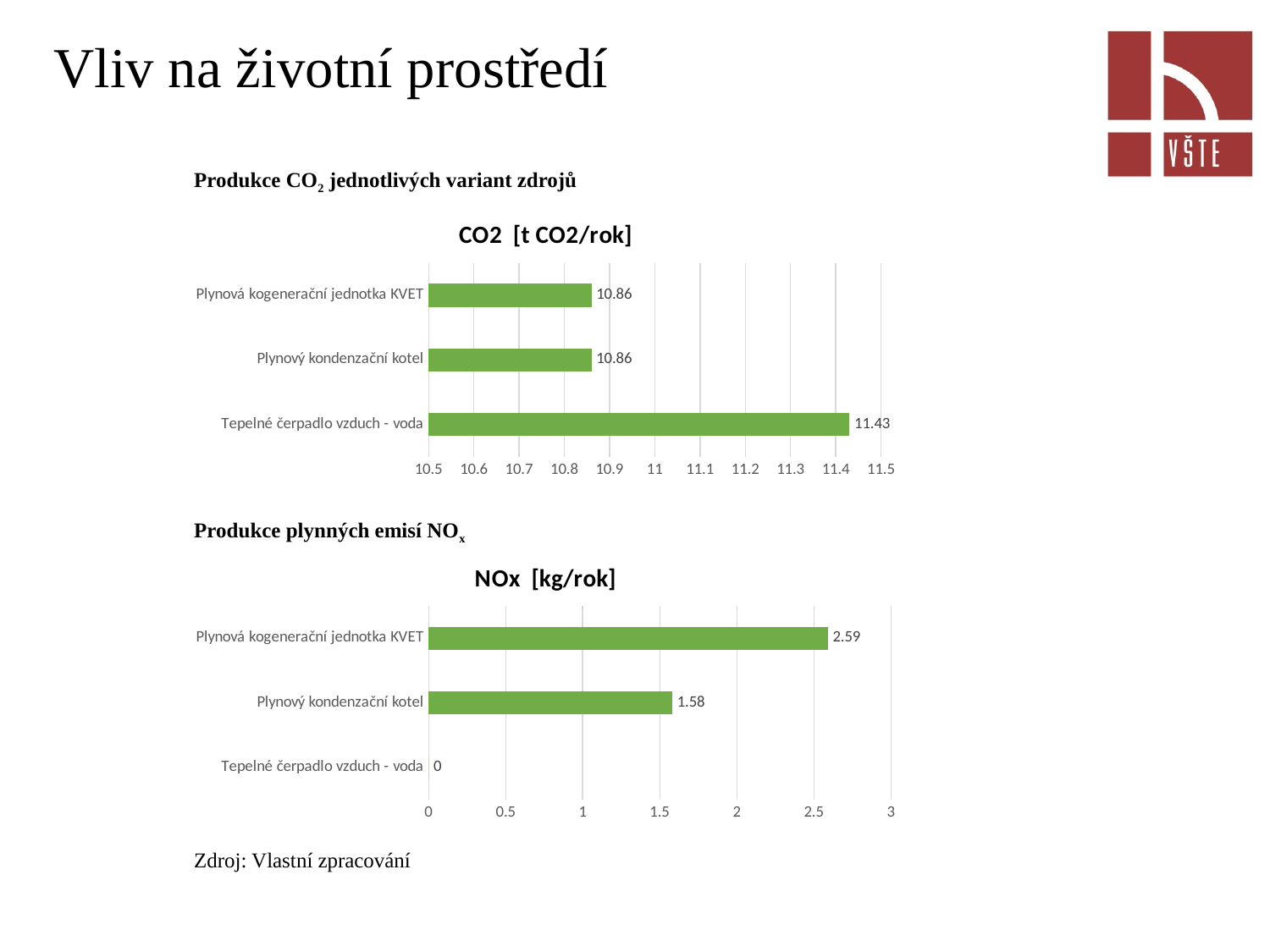
In the CO2 [t CO2/rok] chart, how many categories are shown? 3 In the NOx [kg/rok] chart, what is the value for Plynová kogenerační jednotka KVET? 2.59 In the CO2 [t CO2/rok] chart, which category has the highest value? Tepelné čerpadlo vzduch - voda In the NOx [kg/rok] chart, which is larger: Plynová kogenerační jednotka KVET or Plynový kondenzační kotel? Plynová kogenerační jednotka KVET In the CO2 [t CO2/rok] chart, what is the value for Tepelné čerpadlo vzduch - voda? 11.43 In the NOx [kg/rok] chart, what is the value for Tepelné čerpadlo vzduch - voda? 0 In the NOx [kg/rok] chart, is the value for Plynový kondenzační kotel greater or less than 2? less In the NOx [kg/rok] chart, what is the difference between Plynová kogenerační jednotka KVET and Plynový kondenzační kotel? 1.01 What kind of chart is the NOx [kg/rok] chart? bar chart In the NOx [kg/rok] chart, which category has the lowest value? Tepelné čerpadlo vzduch - voda In the CO2 [t CO2/rok] chart, what is the value for Plynový kondenzační kotel? 10.86 In the CO2 [t CO2/rok] chart, what is the difference between Tepelné čerpadlo vzduch - voda and Plynová kogenerační jednotka KVET? 0.57